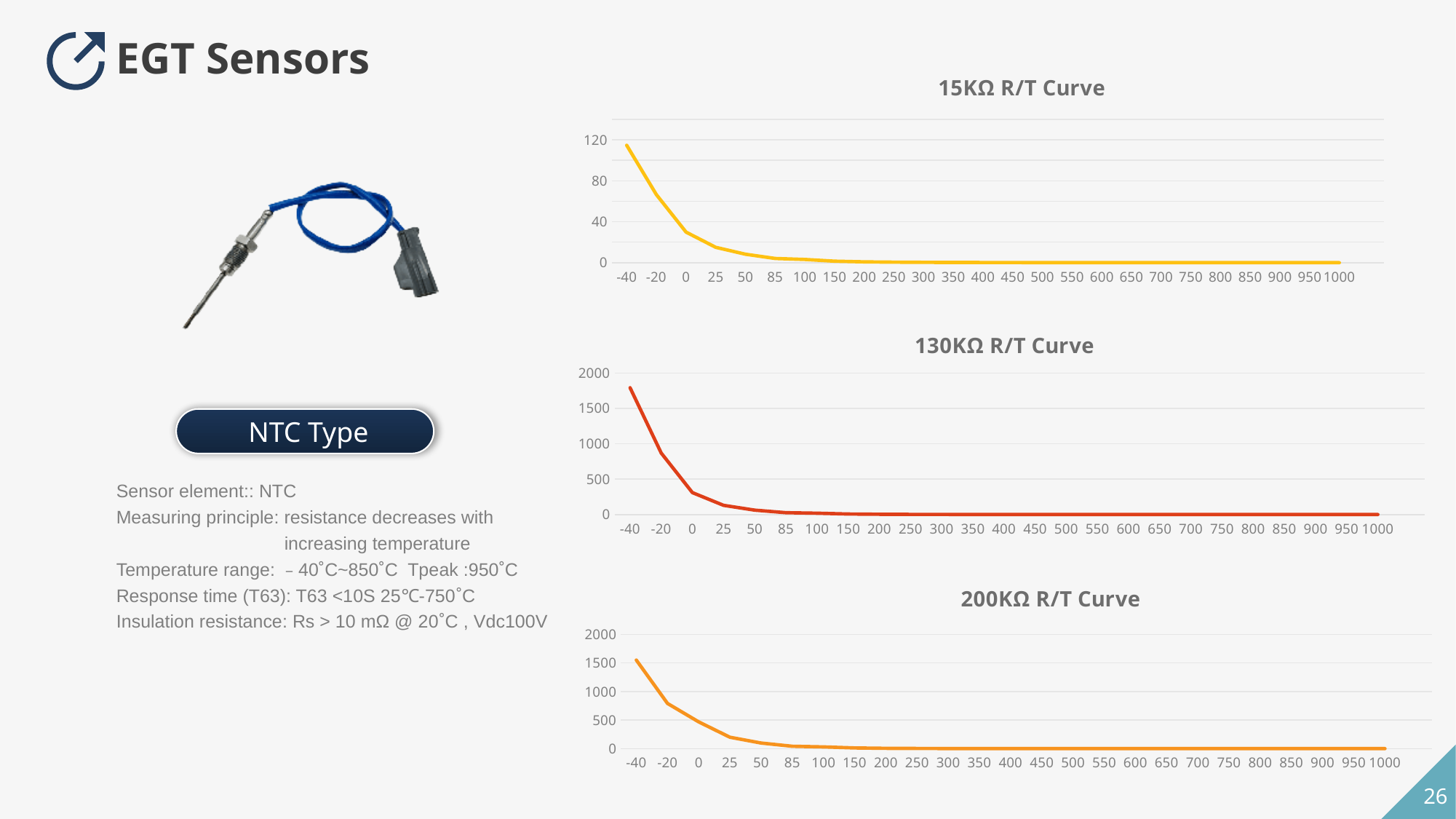
In the 130KΩ R/T Curve chart, is the value at -40 greater or less than 1500? greater In the 130KΩ R/T Curve chart, do the values rise or fall as temperature increases along the x axis? fall In the 130KΩ R/T Curve chart, is the value at 0 greater or less than 500? less In the 15KΩ R/T Curve chart, is the value at 0 greater or less than 40? less How many x-axis categories are shown in the 200KΩ R/T Curve chart? 25 What is the title of the middle chart on the slide? 130KΩ R/T Curve What is the highest y-axis tick label shown on the 15KΩ R/T Curve chart? 120 In the 200KΩ R/T Curve chart, at which x-axis value is the curve highest? -40 What kind of chart is the 15KΩ R/T Curve chart? line chart In the 15KΩ R/T Curve chart, which is larger, the value at -40 or the value at 25? -40